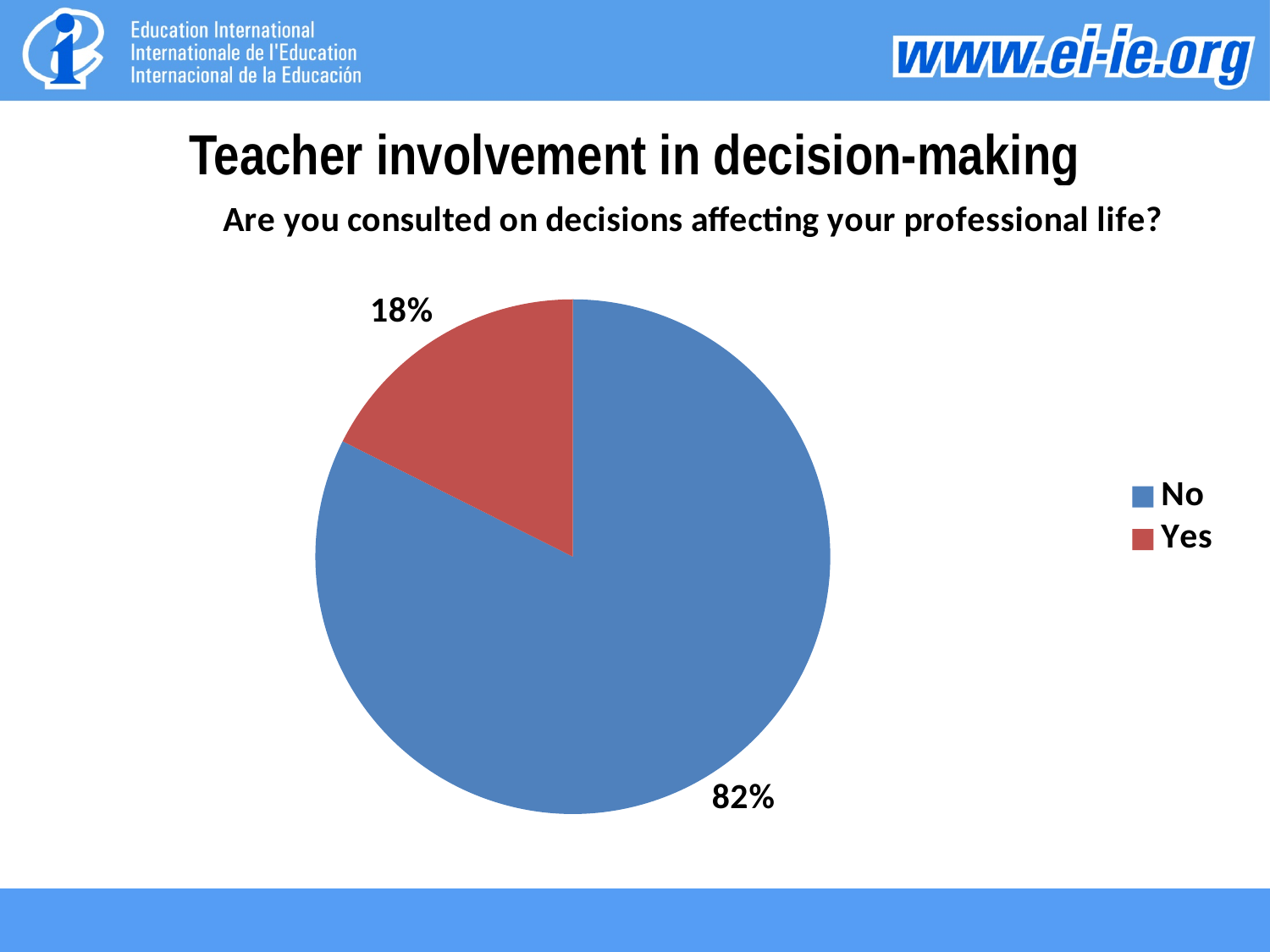
What kind of chart is shown on the slide? pie chart What percentage of the pie is the "No" slice? 82% Which slice of the pie is the largest? No How many entries does the legend list? 2 What is the difference in percentage points between the "No" and "Yes" slices? 64 What question is the pie chart answering, as shown in the chart title? Are you consulted on decisions affecting your professional life? How many slices does the pie chart have? 2 What percentage of the pie is the "Yes" slice? 18% What colour is the "Yes" slice in the pie chart? red What share of the pie does the "Yes" slice represent? 18% Which slice of the pie is the smallest? Yes Which is larger, the "Yes" slice or the "No" slice? No